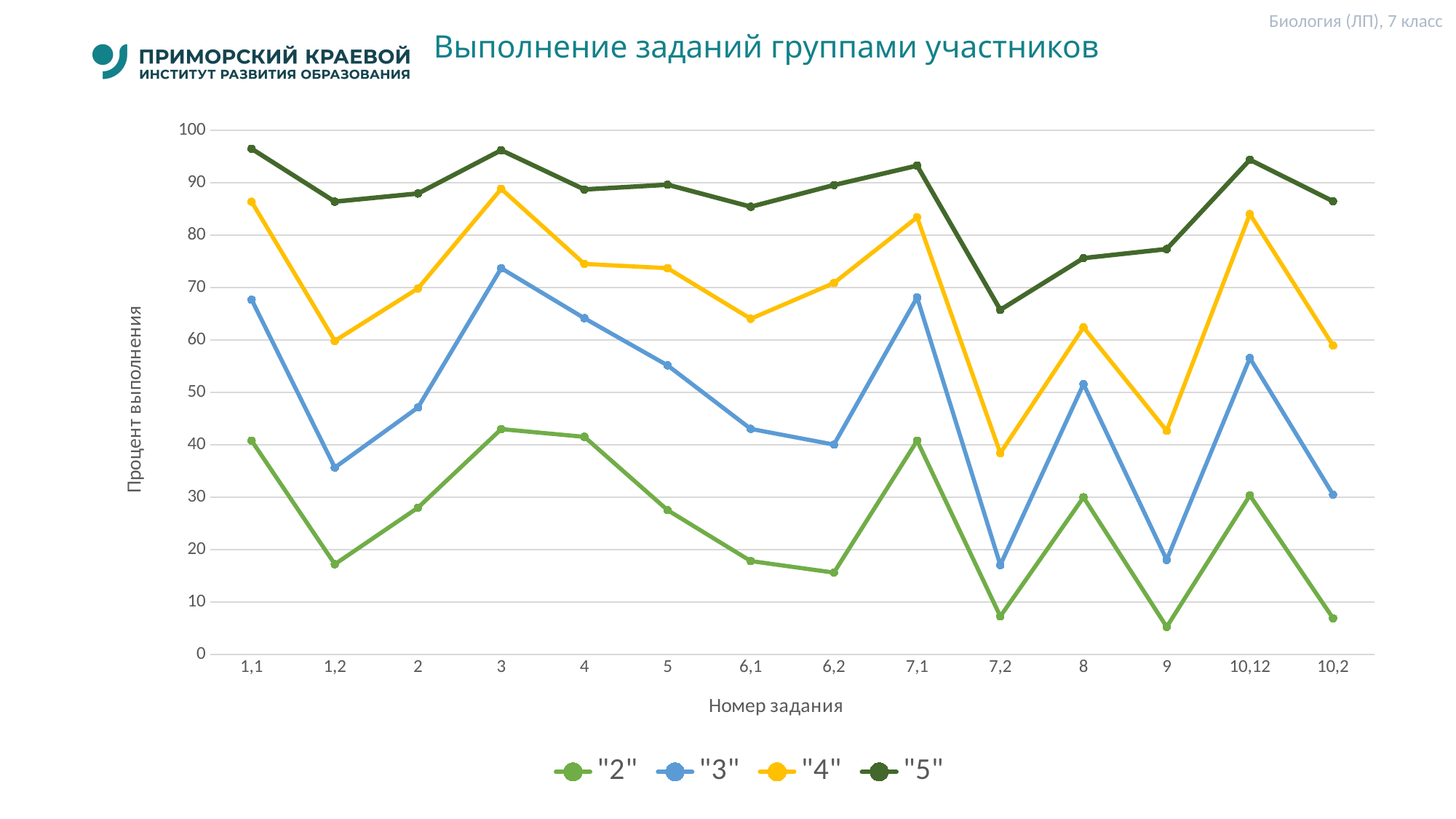
For which task number is the value of series "4" lowest? 7,2 For which task number is the value of series "5" lowest? 7,2 Is the value for series "2" at task 9 greater or less than 10? less What kind of chart is shown on the slide? line chart How many series does the legend list? 4 Which is larger for series "3": the value at task 8 or the value at task 9? task 8 Is the value for series "3" at task 3 greater or less than 70? greater What is the title of the vertical axis? Процент выполнения For which task number is the value of series "3" highest? 3 How many task numbers are shown along the x axis? 14 Does the value of series "2" rise or fall from task 7,1 to task 7,2? fall Is the value for series "5" at task 7,2 greater or less than 70? less